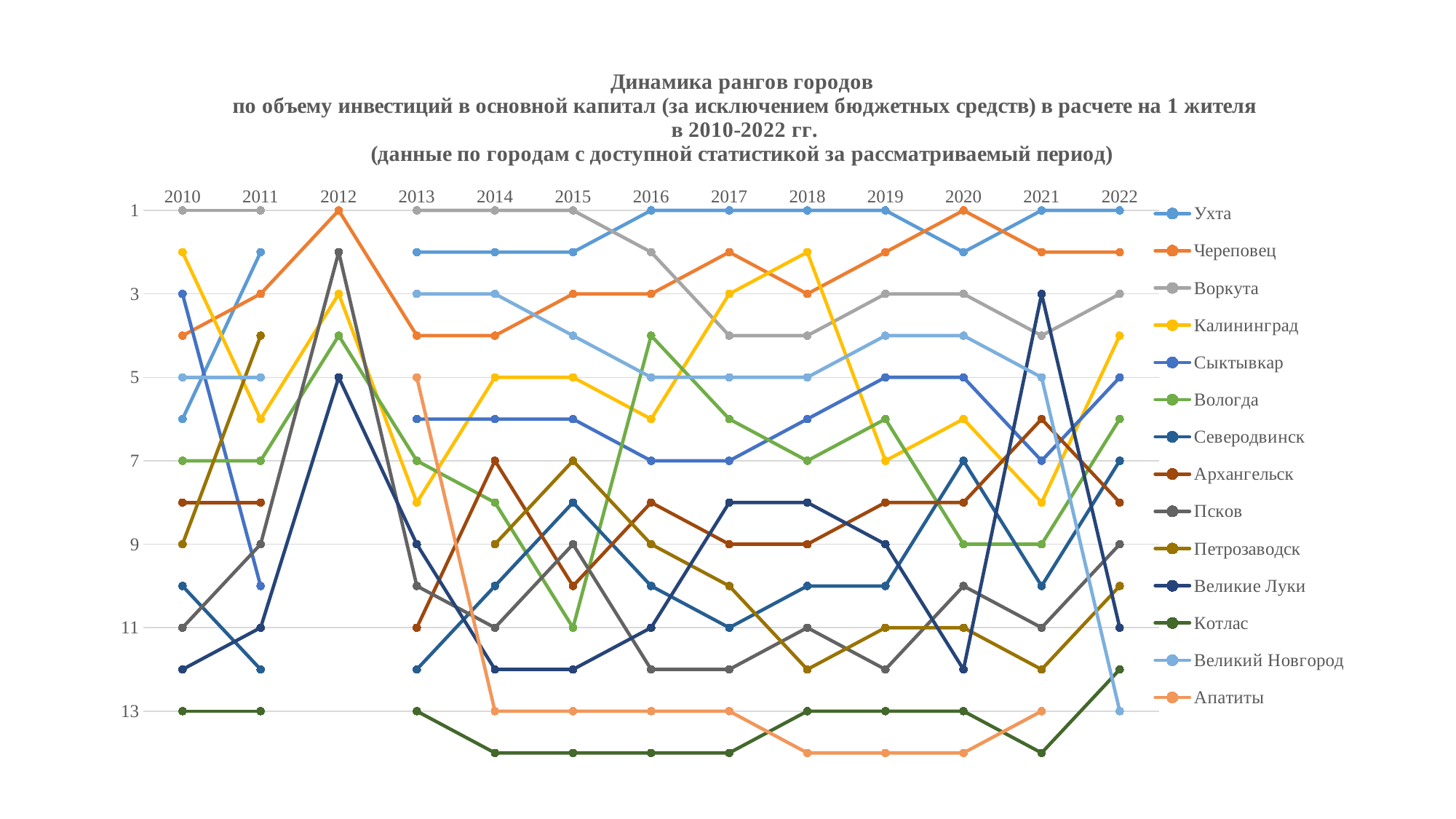
What rank does Череповец have in 2012? 1 How many years are shown along the x axis? 13 What rank does Великий Новгород have in 2022? 13 What rank does Ухта have in 2022? 1 Which city has the smaller rank value in 2022, Ухта or Котлас? Ухта What rank does Котлас have in 2010? 13 Is the rank value for Апатиты in 2018 greater or less than 13? greater What rank does Калининград have in 2012? 3 How many cities (series) does the legend list? 14 What kind of chart is shown on the slide? line chart What rank does Апатиты have in 2013? 5 What rank does Воркута have in 2010? 1